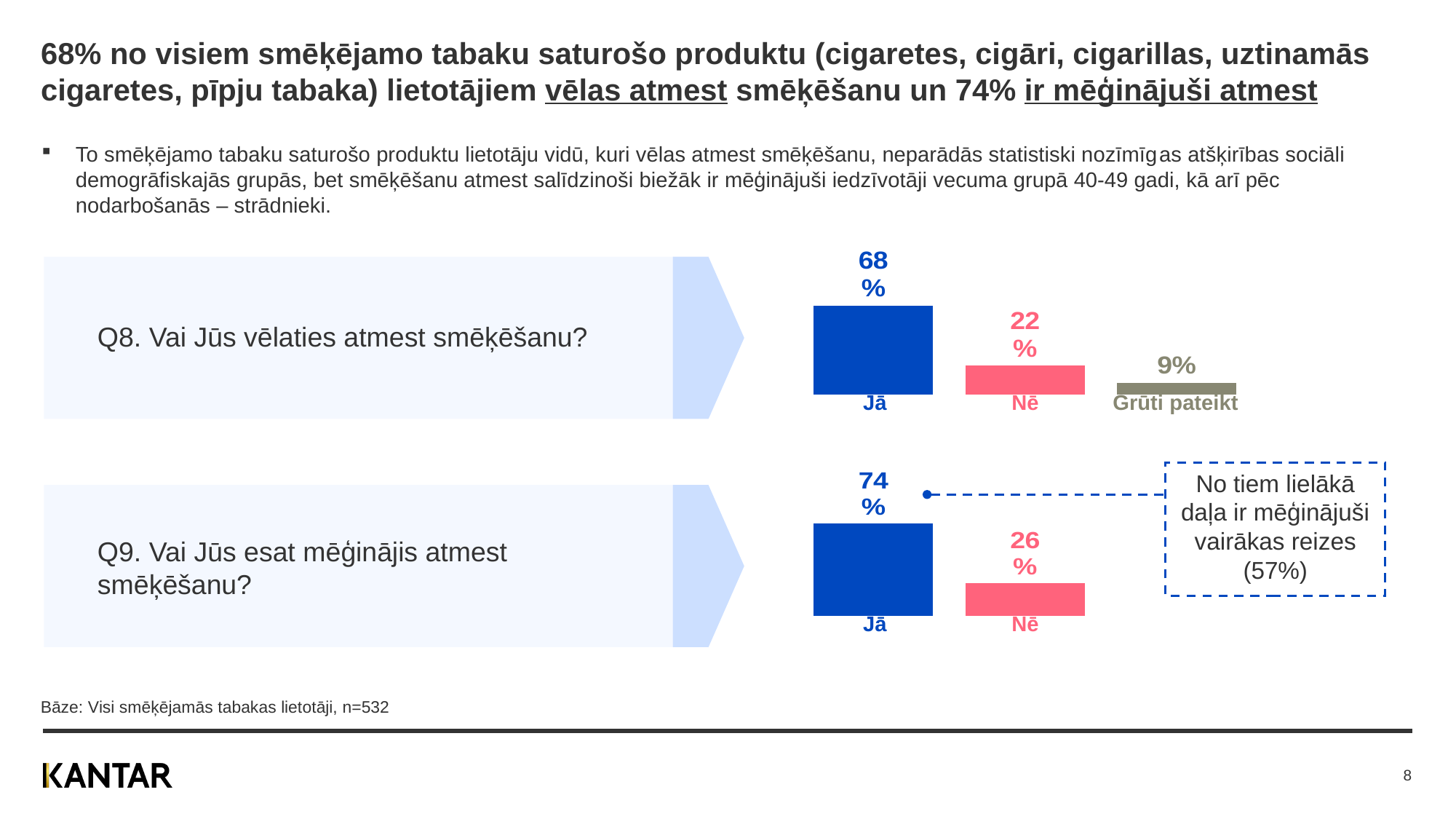
In the Q8 chart, which category has the highest value? Jā In the Q9 chart, which is larger, Jā or Nē? Jā In the Q8 chart, what is the difference between Jā and Nē? 46 percentage points In the Q9 chart, what is the value for Nē? 26% In the Q8 chart (Vai Jūs vēlaties atmest smēķēšanu?), what is the value for Jā? 68% In the Q8 chart, what is the value for Grūti pateikt? 9% In the Q8 chart, which category has the lowest value? Grūti pateikt In the Q9 chart (Vai Jūs esat mēģinājis atmest smēķēšanu?), what is the value for Jā? 74% In the Q8 chart, what is the value for Nē? 22% What type of chart is used for Q8 and Q9? Bar chart In the Q9 chart, what is the difference between Jā and Nē? 48 percentage points How many categories are shown in the Q8 chart? 3